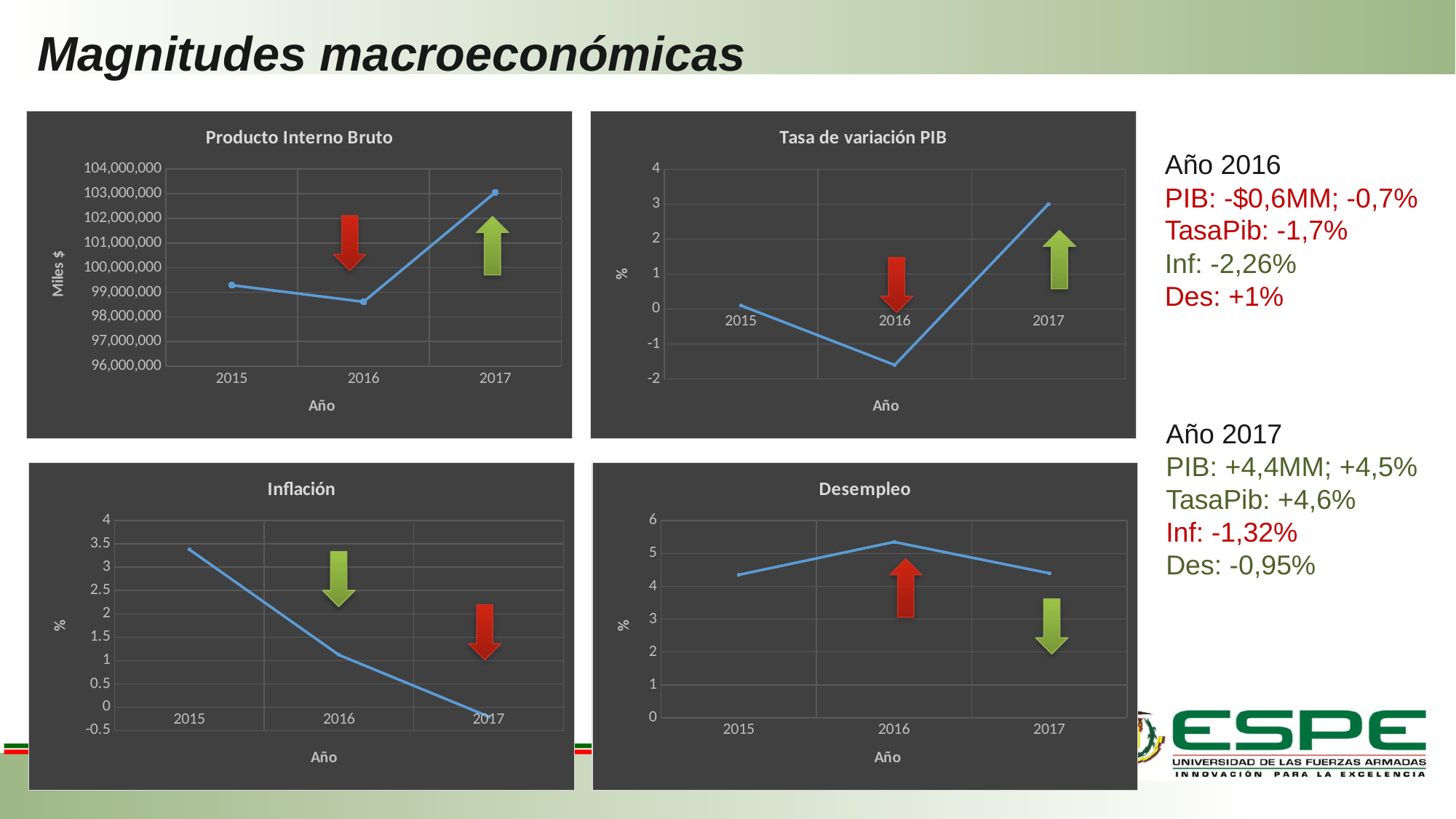
How many charts are shown on the slide? 4 In the 'Producto Interno Bruto' chart, is the value for 2017 greater or less than 102,000,000? greater In the 'Producto Interno Bruto' chart, which year has the highest value? 2017 In the 'Tasa de variación PIB' chart, is the value for 2017 greater or less than 2? greater In the 'Tasa de variación PIB' chart, which year has the lowest value? 2016 In the 'Producto Interno Bruto' chart, which year has the lowest value? 2016 In the 'Desempleo' chart, which year has the highest value? 2016 In the 'Inflación' chart, do the values rise or fall from 2015 to 2017? fall In the 'Inflación' chart, is the value for 2015 greater or less than 3? greater In the 'Producto Interno Bruto' chart, how many years are plotted? 3 What is the y-axis label of the 'Producto Interno Bruto' chart? Miles $ What kind of chart is the 'Producto Interno Bruto' chart? Line chart